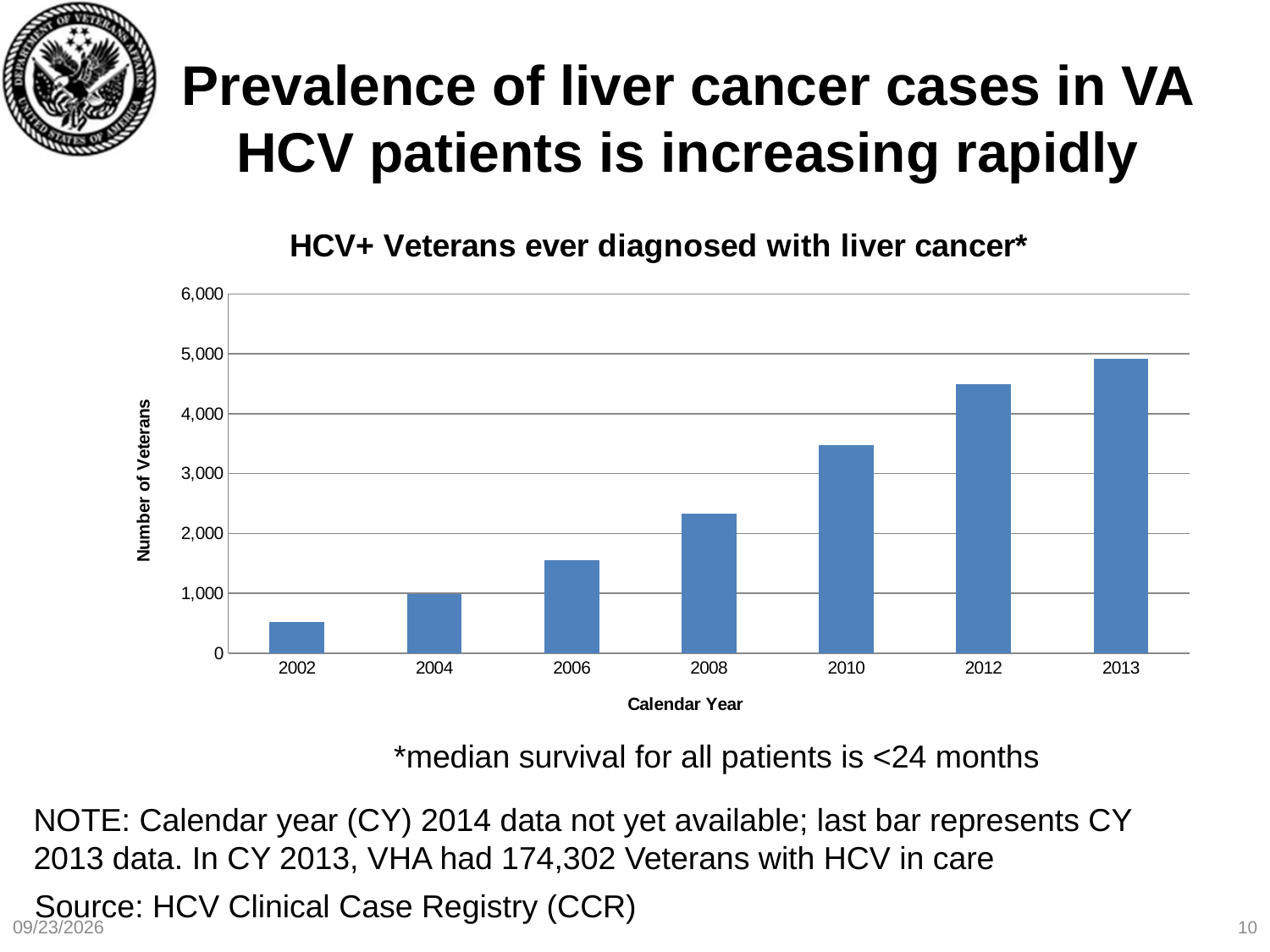
Is the value for 2010 greater or less than 3,000? greater Which calendar year has the highest number of Veterans? 2013 What kind of chart is shown on the slide? bar chart Do the values rise or fall from 2002 to 2013? rise Which is larger, the value for 2010 or the value for 2008? 2010 Is the value for 2008 greater or less than 2,000? greater Is the value for 2012 greater or less than 4,000? greater How many calendar years are plotted on the x axis? 7 What is the title of the chart? HCV+ Veterans ever diagnosed with liver cancer* Which calendar year has the lowest number of Veterans? 2002